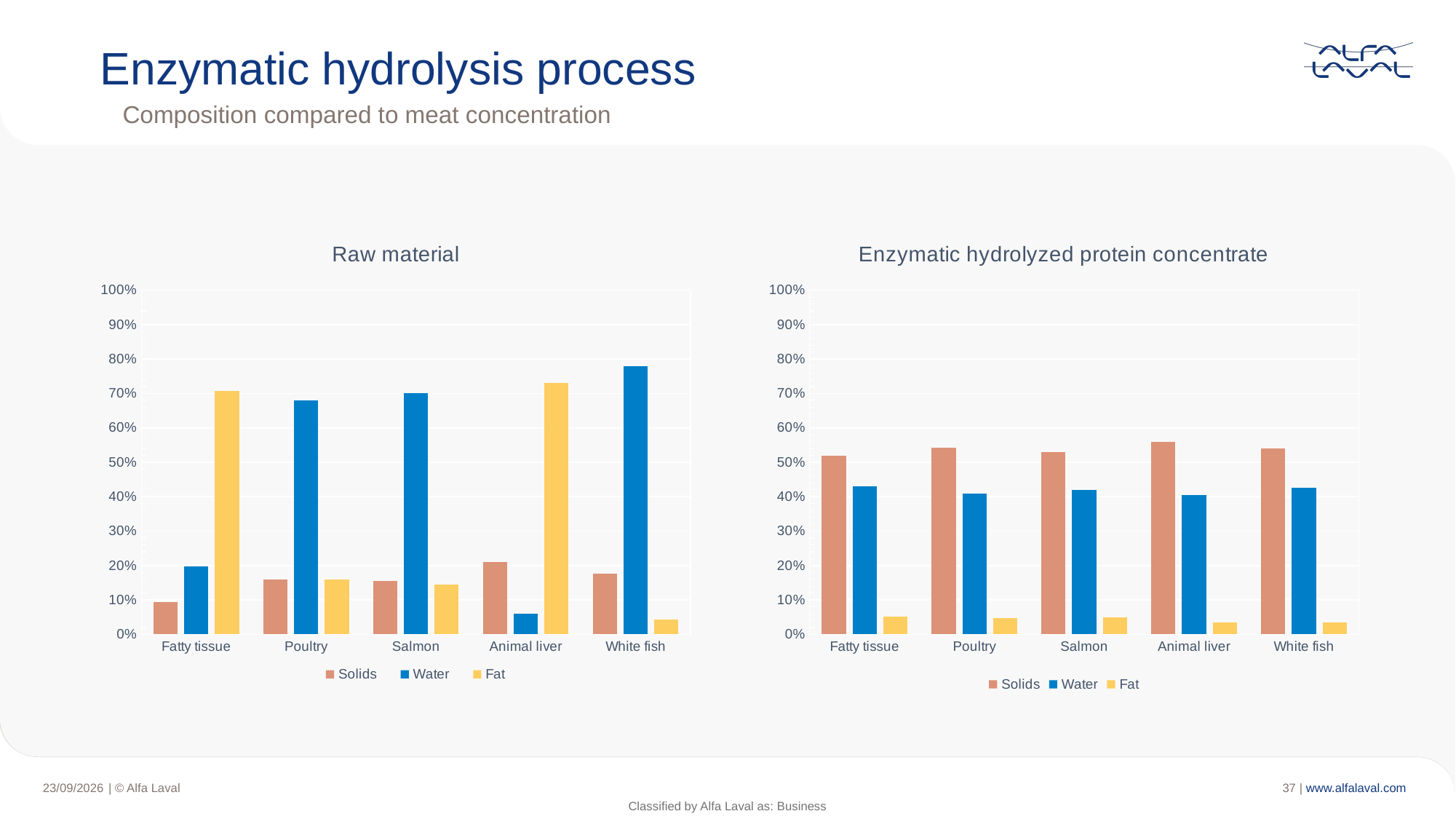
How many series does the legend of the Enzymatic hydrolyzed protein concentrate chart list? 3 In the Raw material chart, is the Water value for Animal liver greater or less than 10%? less How many categories are shown on the x axis of the Raw material chart? 5 In the Enzymatic hydrolyzed protein concentrate chart, is the Fat value for White fish greater or less than 10%? less In the Enzymatic hydrolyzed protein concentrate chart, which series has the lowest values across all categories? Fat In the Raw material chart, which category has the lowest Water value? Animal liver In the Enzymatic hydrolyzed protein concentrate chart, is the Solids value for Animal liver greater or less than 50%? greater In the Raw material chart, which category has the highest Water value? White fish In the Enzymatic hydrolyzed protein concentrate chart, which is larger for Salmon, Solids or Water? Solids In the Raw material chart, which is larger for Poultry, Water or Fat? Water What kind of chart is the Raw material chart? bar chart